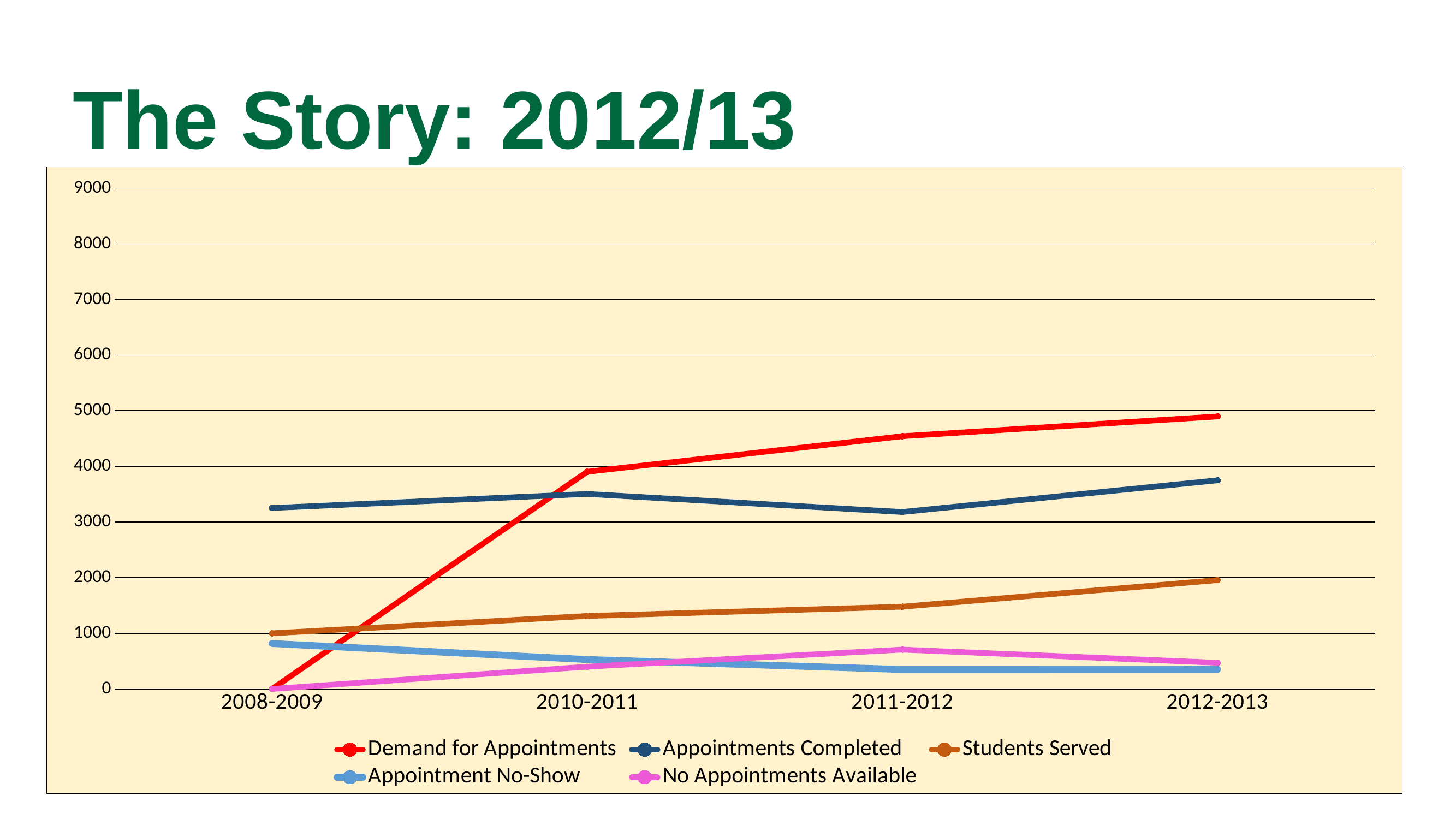
Which series has the highest value in 2012-2013? Demand for Appointments Does the Demand for Appointments line rise or fall from 2008-2009 to 2012-2013? rise In 2012-2013, which is larger: Demand for Appointments or Appointments Completed? Demand for Appointments Is the value for Appointment No-Show in 2008-2009 greater or less than 1000? less How many academic years are plotted along the x axis? 4 What kind of chart is shown on the slide? line chart Is the value for Appointments Completed in 2008-2009 greater or less than 3000? greater Is the value for Students Served in 2012-2013 greater or less than 1000? greater How many series does the legend list? 5 In 2008-2009, which is larger: Appointments Completed or Demand for Appointments? Appointments Completed Does the Students Served line rise or fall across the years shown? rise